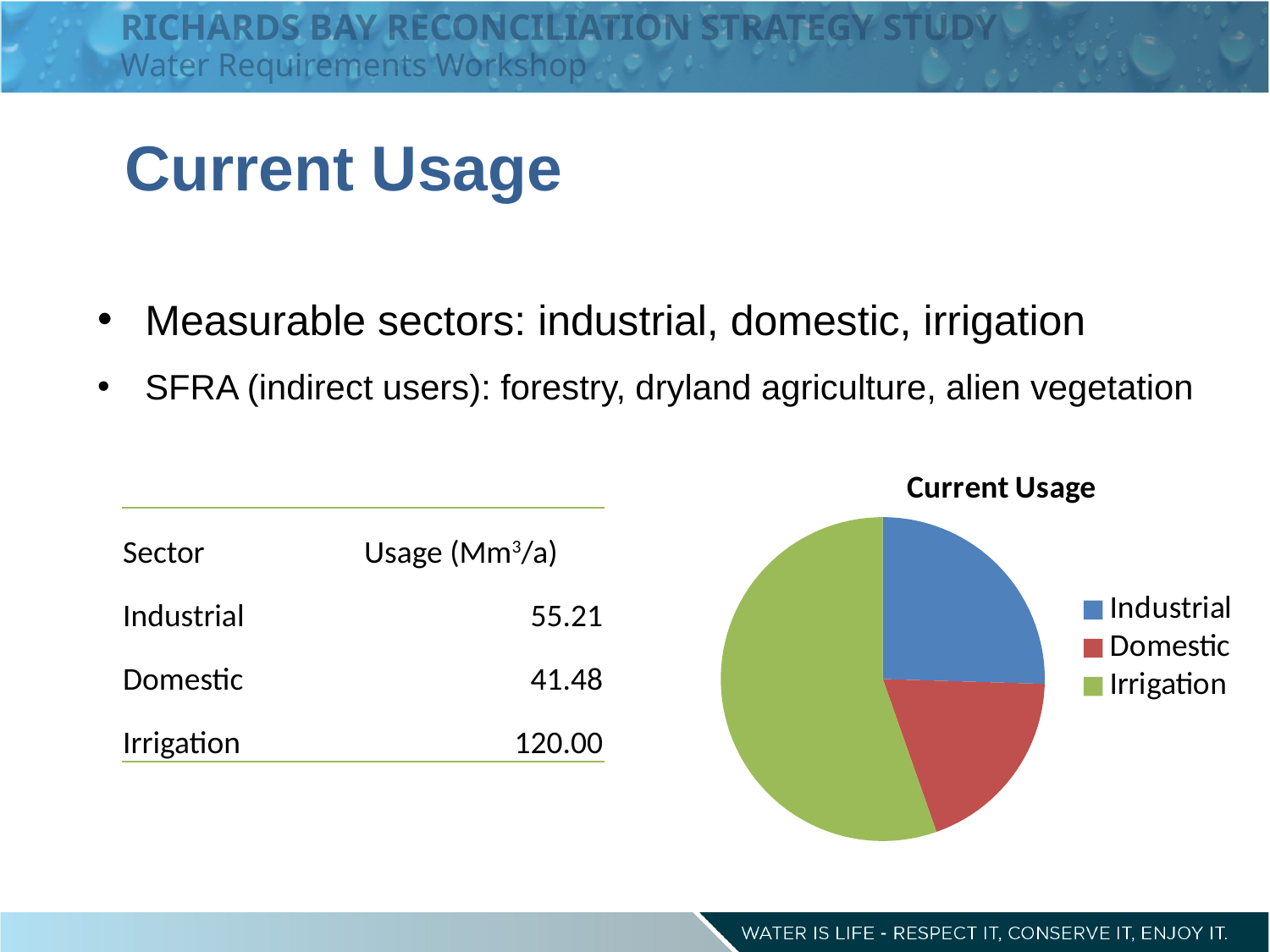
Which slice is larger in the Current Usage pie chart, Irrigation or Domestic? Irrigation What kind of chart is shown on the slide? pie chart How many slices does the Current Usage pie chart have? 3 Which sector has the largest slice in the Current Usage pie chart? Irrigation According to the slide, what is the usage value for Domestic in Mm3/a? 41.48 What is the title of the chart? Current Usage Which slice is larger in the Current Usage pie chart, Industrial or Domestic? Industrial Which sector has the smallest slice in the Current Usage pie chart? Domestic According to the slide, what is the usage value for Industrial in Mm3/a? 55.21 How many entries does the legend of the Current Usage chart list? 3 According to the slide, what is the usage value for Irrigation in Mm3/a? 120.00 What colour is the Irrigation slice in the Current Usage pie chart? green